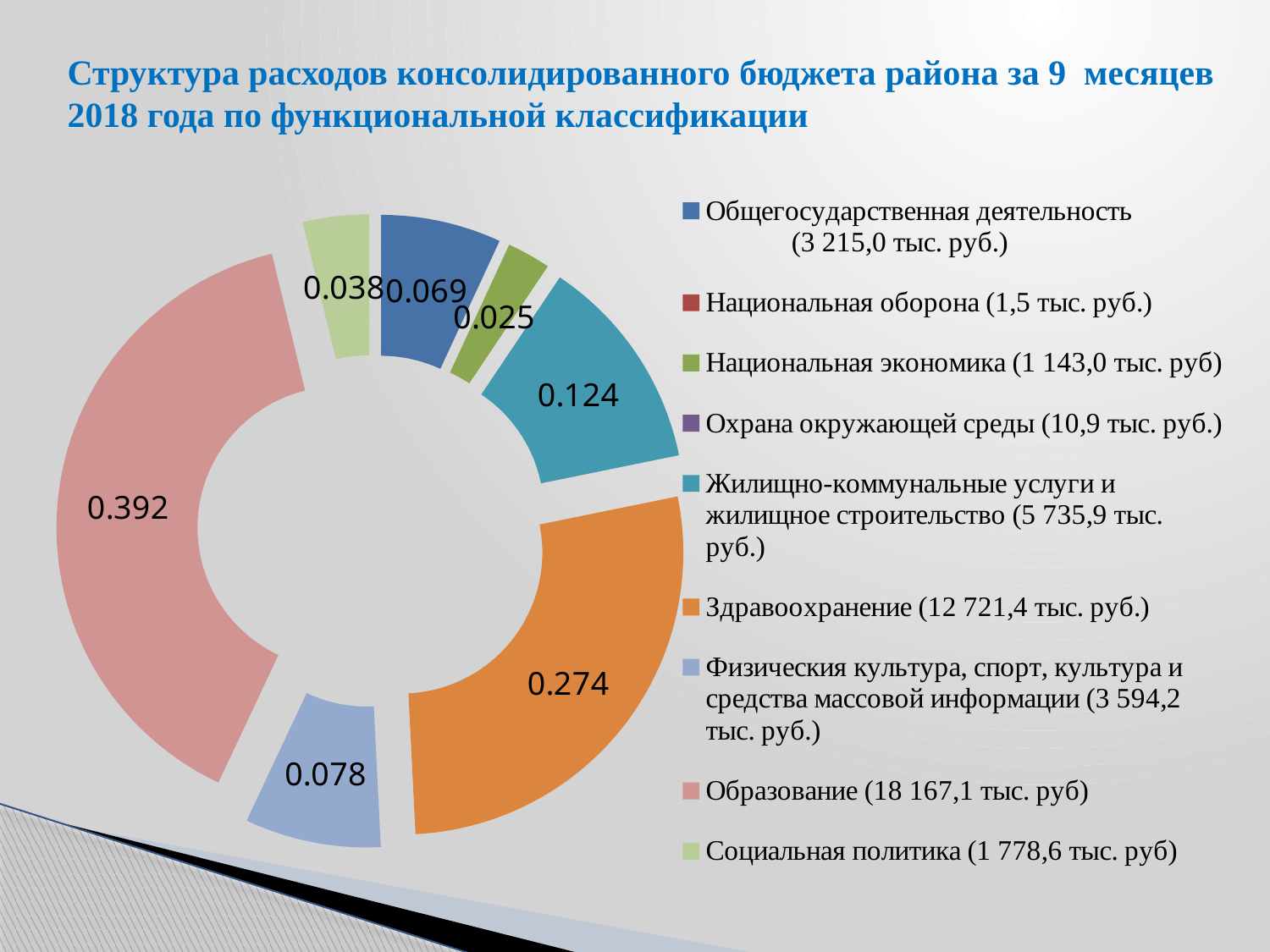
What share is shown for Общегосударственная деятельность? 0.069 What is the difference between the shares for Образование and Здравоохранение? 0.118 What kind of chart is shown on the slide? Doughnut (pie) chart What colour is the slice for Здравоохранение? Orange How many categories does the legend list? 9 Which is larger: the share for Здравоохранение or for Жилищно-коммунальные услуги и жилищное строительство? Здравоохранение According to the legend, what is the amount for Образование in thousand rubles? 18 167,1 тыс. руб Which category has the largest share of expenditures? Образование What share is shown for Социальная политика? 0.038 What share is shown for Здравоохранение? 0.274 What share is shown for Жилищно-коммунальные услуги и жилищное строительство? 0.124 What share is shown for Образование? 0.392